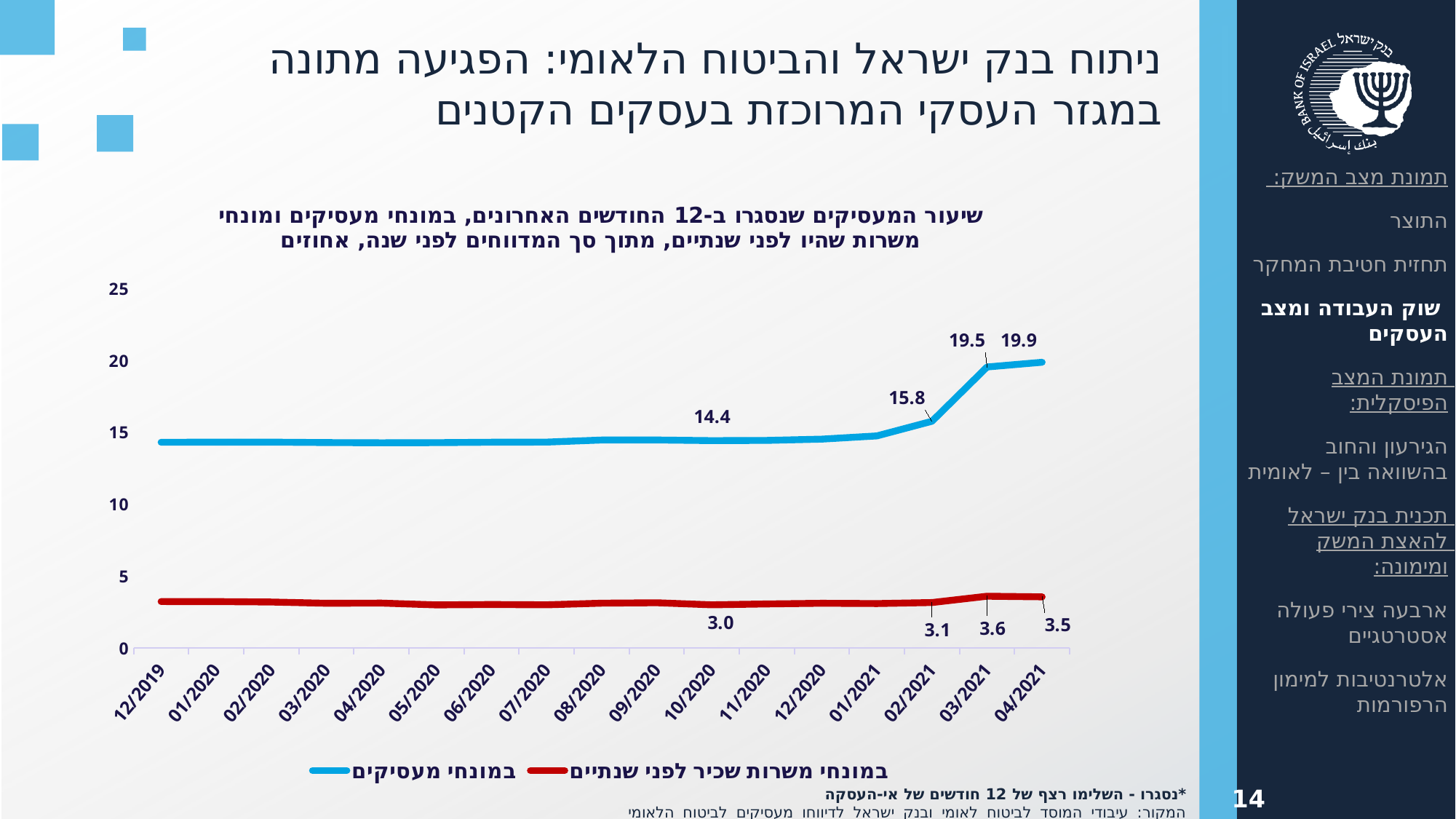
What is the value of the 'במונחי משרות שכיר לפני שנתיים' series in 10/2020? 3.0 By how much did the 'במונחי מעסיקים' series rise from 02/2021 to 03/2021? 3.7 Which series has the higher value in 04/2021, 'במונחי מעסיקים' or 'במונחי משרות שכיר לפני שנתיים'? במונחי מעסיקים What is the value of the 'במונחי מעסיקים' series in 04/2021? 19.9 Is the value of the 'במונחי מעסיקים' series in 12/2019 greater or less than 15? less What is the difference between the two series in 04/2021? 16.4 How many series does the legend list? 2 What type of chart is shown on the slide? line chart What is the value of the 'במונחי משרות שכיר לפני שנתיים' series in 03/2021? 3.6 What is the value of the 'במונחי מעסיקים' series in 03/2021? 19.5 How many time points are shown on the x axis? 17 Does the 'במונחי מעסיקים' series rise or fall between 10/2020 and 04/2021? rise